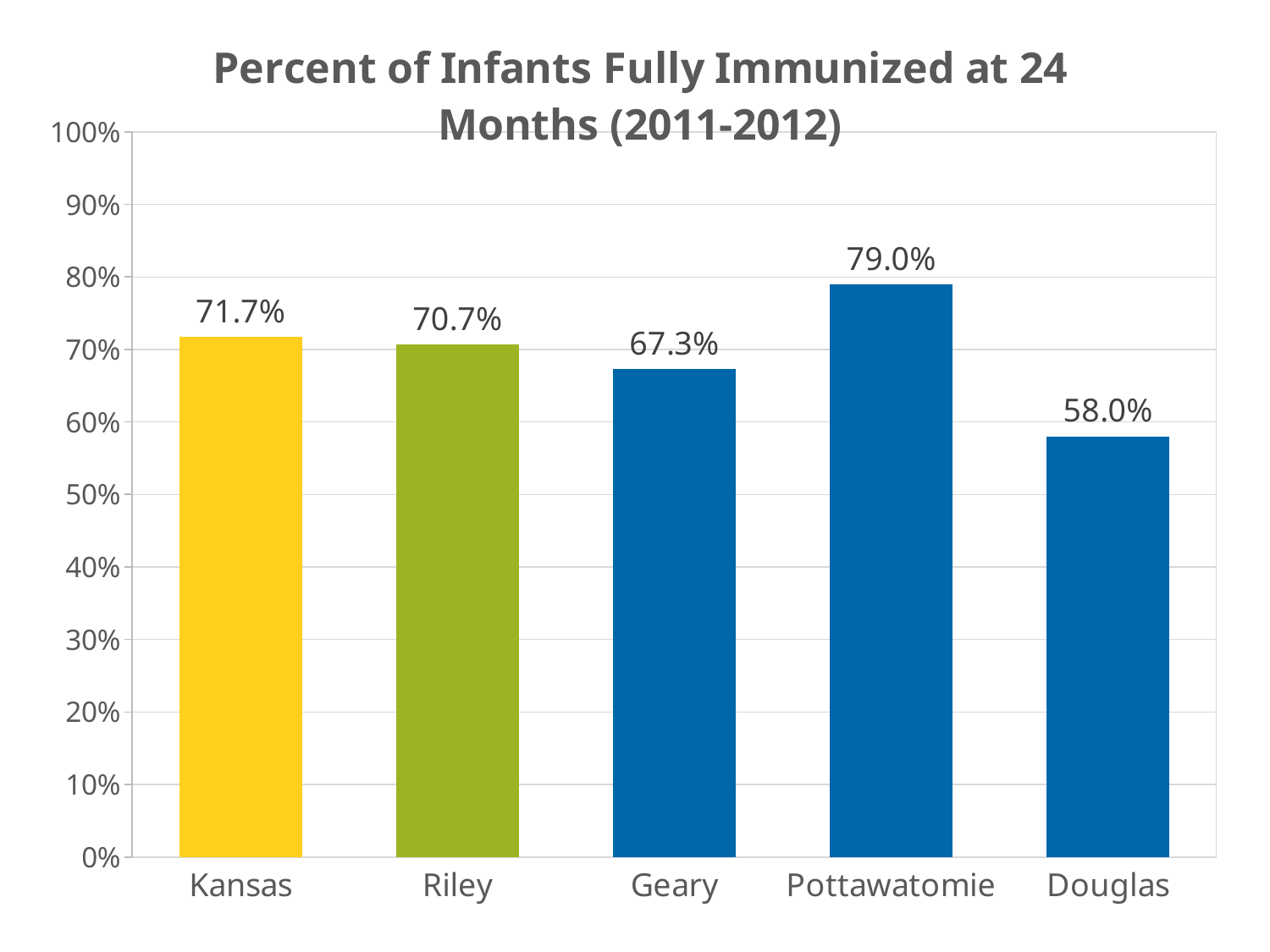
Which category has the lowest value? Douglas Which is larger, the value for Geary or the value for Douglas? Geary What is the difference between the values for Kansas and Geary? 4.4% How many categories are shown on the x axis? 5 What is the value for Pottawatomie? 79.0% What is the value for Douglas? 58.0% What is the title of the chart? Percent of Infants Fully Immunized at 24 Months (2011-2012) What is the value for Kansas? 71.7% Is the value for Riley greater or less than 60%? greater What is the difference between the values for Pottawatomie and Douglas? 21.0% Which category has the highest value? Pottawatomie What kind of chart is shown on the slide? bar chart